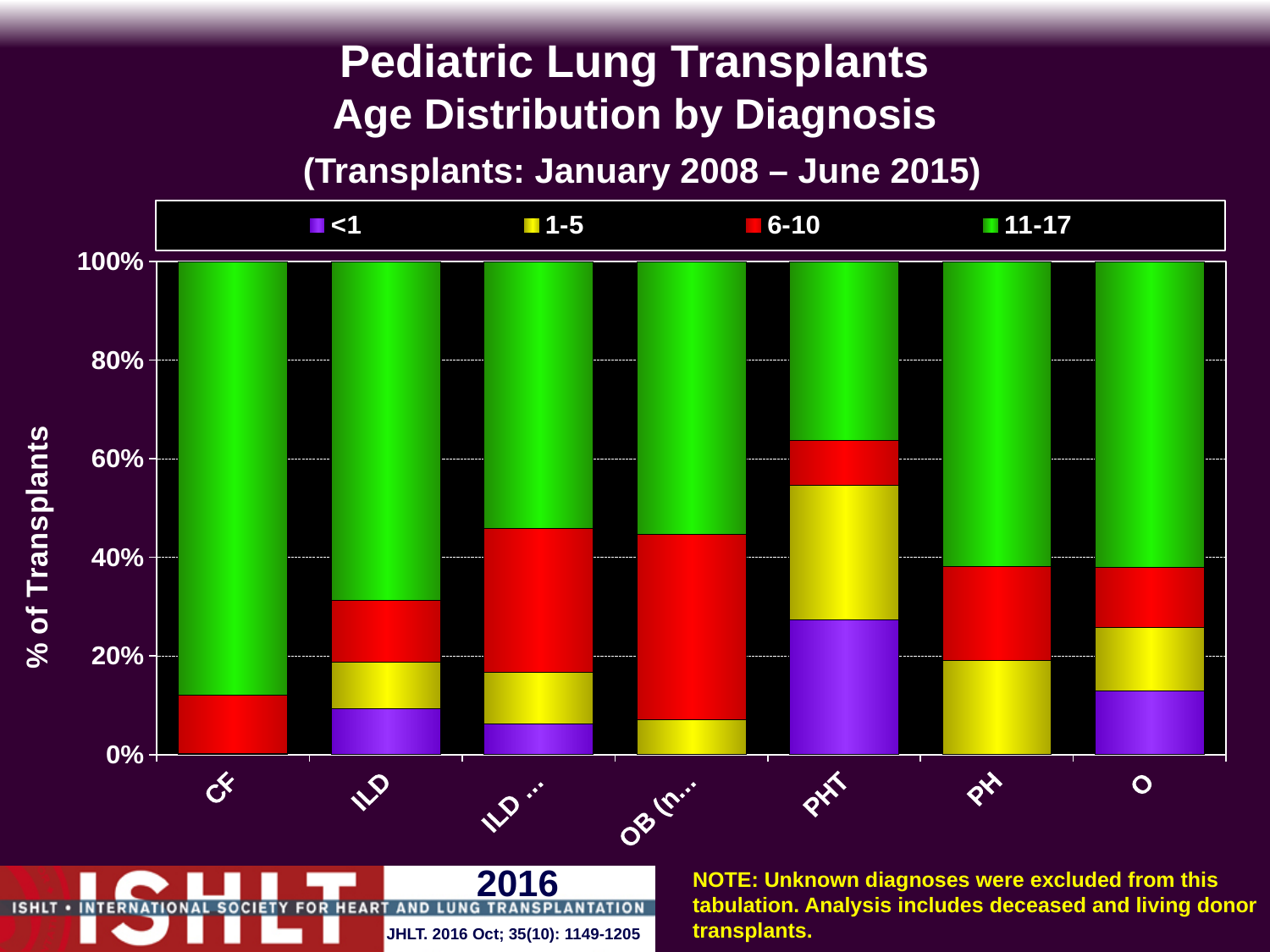
Is the share of the 11-17 age group for CF greater or less than 80%? greater How many diagnosis categories are plotted along the x axis? 7 Is the share of the <1 age group for O greater or less than 20%? less Is the share of the <1 age group for PHT greater or less than 20%? greater Which age group does the green segment represent according to the legend? 11-17 What is the title of the chart? Pediatric Lung Transplants Age Distribution by Diagnosis How many series does the legend list? 4 What kind of chart is shown on the slide? Stacked bar chart Which diagnosis category has the largest share of transplants in the <1 age group? PHT Which diagnosis category has the largest share of transplants in the 11-17 age group? CF Which has a larger share of the <1 age group, PHT or ILD? PHT